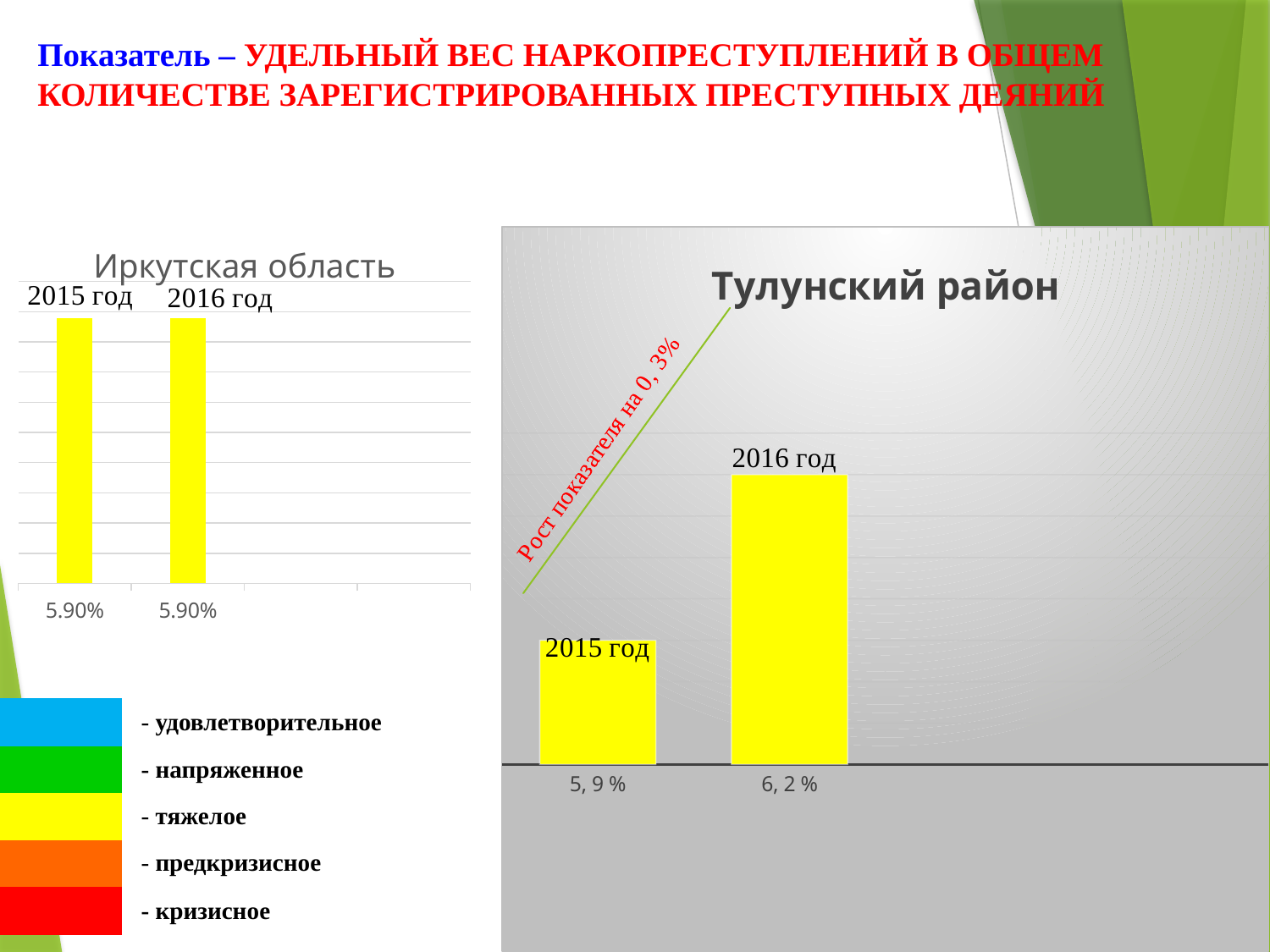
In the 'Тулунский район' chart, is the value for 2016 год larger or smaller than the value for 2015 год? larger In the 'Тулунский район' chart, what is the value for 2016 год? 6, 2 % In the 'Тулунский район' chart, does the value rise or fall from 2015 год to 2016 год? rise What colour are the bars in the 'Иркутская область' chart? yellow In the 'Тулунский район' chart, which year has the lower value? 2015 год In the 'Иркутская область' chart, what is the value for 2015 год? 5.90% How many bars are shown in the 'Иркутская область' chart? 2 In the 'Тулунский район' chart, by how much does the value for 2016 год exceed the value for 2015 год? 0,3% In the 'Тулунский район' chart, which year has the higher value? 2016 год In the 'Тулунский район' chart, what is the value for 2015 год? 5, 9 % In the 'Иркутская область' chart, what is the value for 2016 год? 5.90% What kind of chart is the 'Тулунский район' chart? bar chart